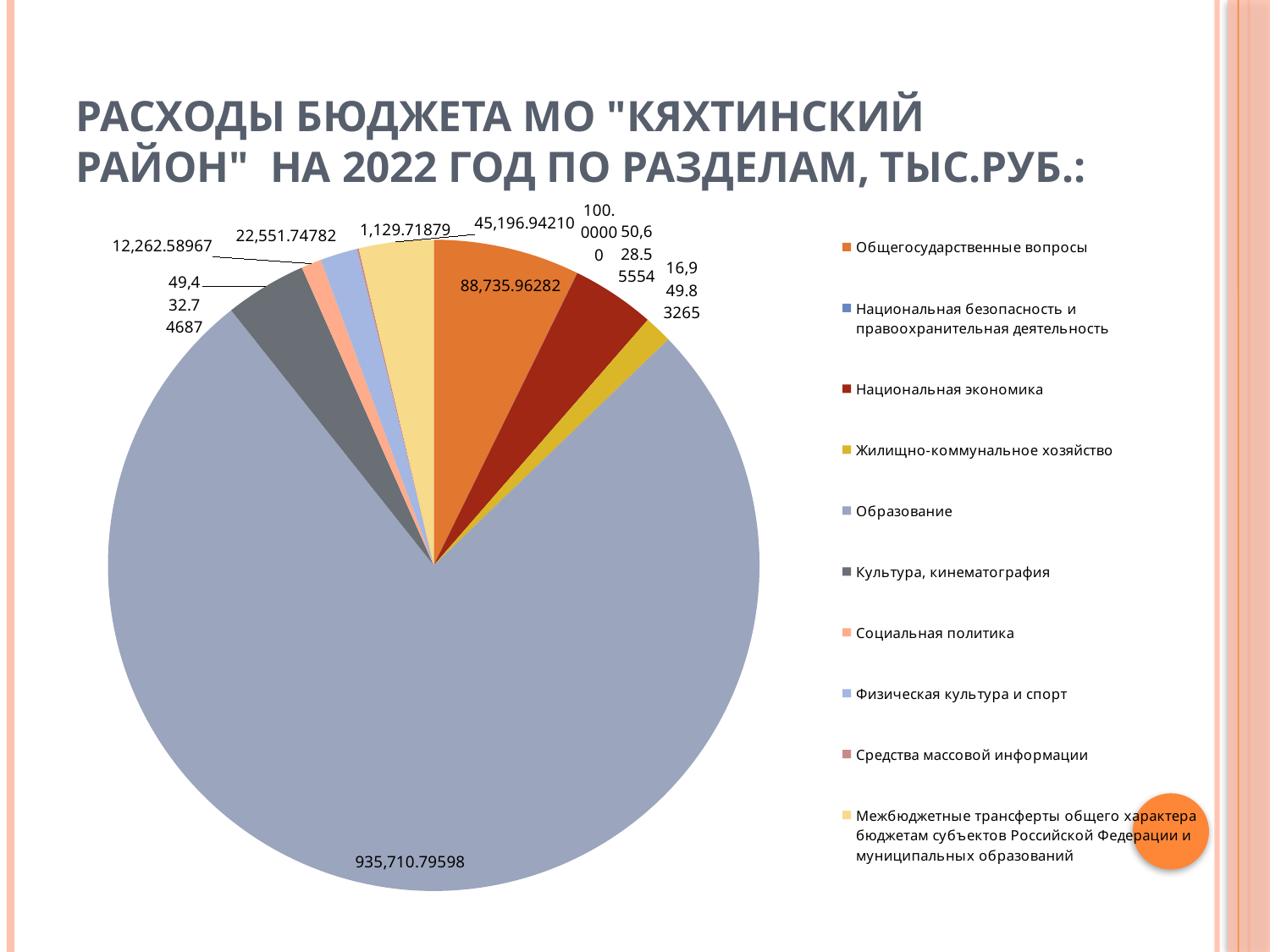
What is the value for Средства массовой информации? 1,129.71879 What is the value for Общегосударственные вопросы? 88,735.96282 What is the value for Образование? 935,710.79598 Which is larger: Общегосударственные вопросы or Межбюджетные трансферты общего характера? Общегосударственные вопросы How many sections (categories) does the legend list? 10 What is the value for Межбюджетные трансферты общего характера бюджетам субъектов Российской Федерации и муниципальных образований? 45,196.94210 What kind of chart is shown on the slide? Pie chart What is the title of the chart on the slide? РАСХОДЫ БЮДЖЕТА МО "КЯХТИНСКИЙ РАЙОН" НА 2022 ГОД ПО РАЗДЕЛАМ, ТЫС.РУБ.: What is the value for Социальная политика? 12,262.58967 Which section has the largest share of the pie? Образование What is the difference between Физическая культура и спорт and Социальная политика? 10,289.15815 What is the value for Физическая культура и спорт? 22,551.74782